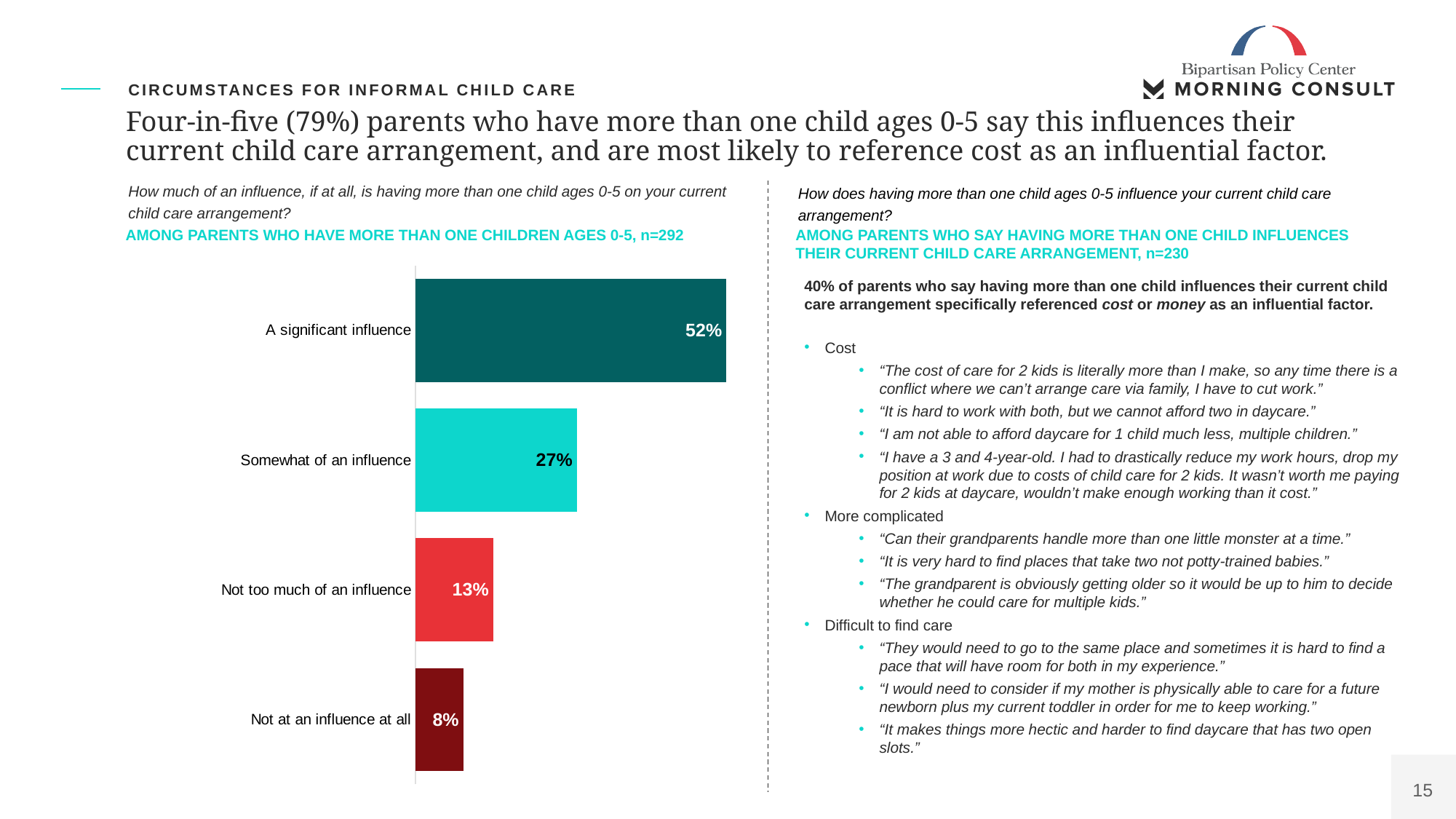
What percentage of parents say having more than one child ages 0-5 is not too much of an influence? 13% What is the difference in percentage points between 'A significant influence' and 'Somewhat of an influence'? 25 How many response categories are shown in the bar chart? 4 What is the combined percentage of parents who say having more than one child is 'A significant influence' or 'Somewhat of an influence'? 79% Which is larger: the percentage for 'Not too much of an influence' or 'Not at an influence at all'? Not too much of an influence What percentage of parents say having more than one child ages 0-5 is somewhat of an influence? 27% Which response category has the highest percentage in the chart? A significant influence What type of chart is used to show how much having more than one child influences child care arrangements? Bar chart What percentage of parents say having more than one child ages 0-5 is a significant influence on their current child care arrangement? 52% What percentage of parents say having more than one child ages 0-5 is not an influence at all? 8% What is the sample size (n) for the bar chart of parents who have more than one child ages 0-5? n=292 Which response category has the lowest percentage in the chart? Not at an influence at all